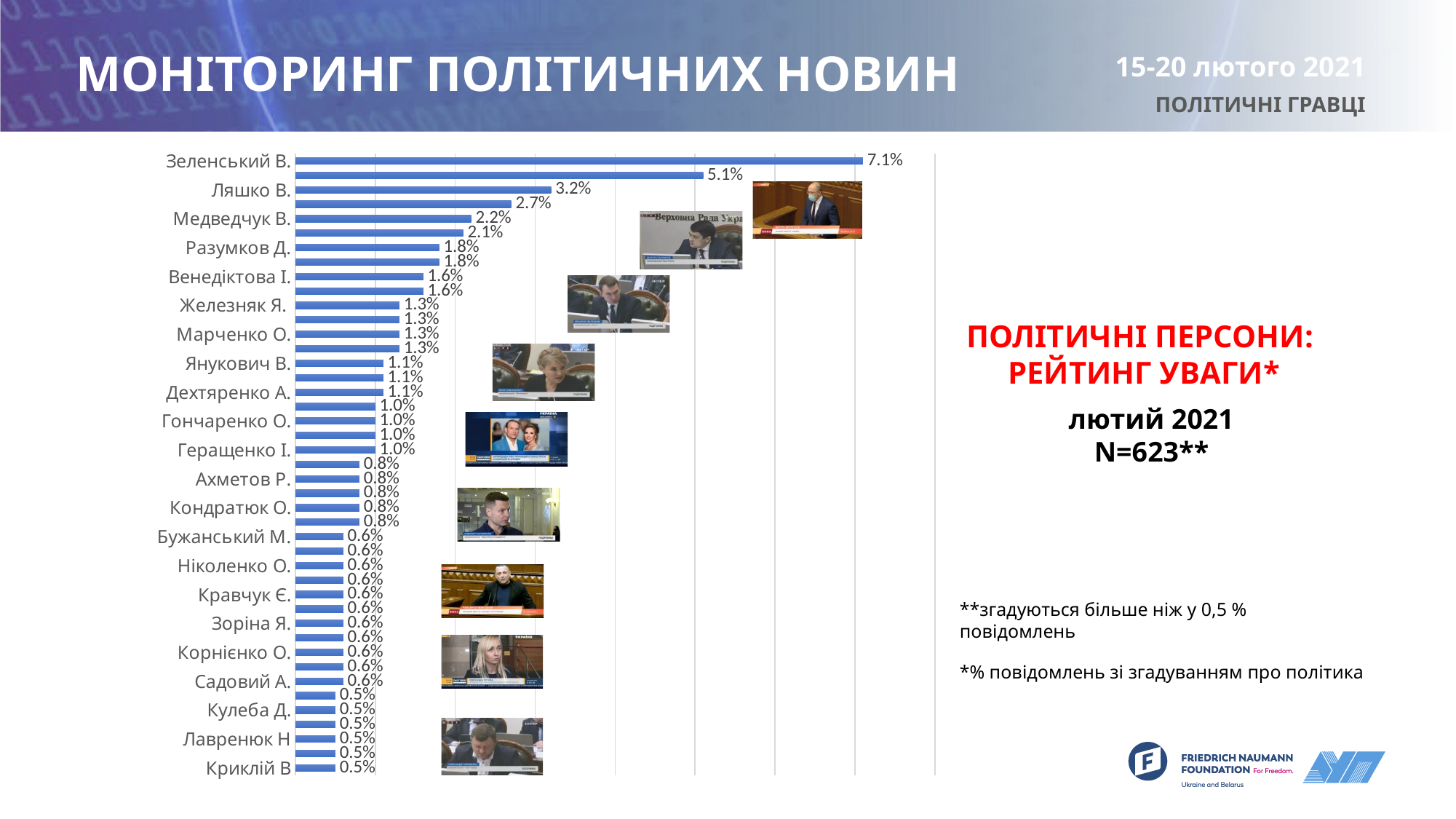
What period does the slide header say the monitoring covers? 15-20 лютого 2021 What kind of chart is shown on the slide? bar chart What is the value shown for Зеленський В.? 7.1% Which politician has the highest attention rating in the chart? Зеленський В. What is the value shown for Криклій В? 0.5% What is the difference between the values for Зеленський В. and Ляшко В.? 3.9% Which has a larger value, Разумков Д. or Янукович В.? Разумков Д. What is the sample size (N) stated next to the chart? N=623** What is the value shown for Венедіктова І.? 1.6% Do the bar values rise or fall going from the top of the chart to the bottom? fall What is the value shown for Медведчук В.? 2.2% What is the value shown for Ляшко В.? 3.2%